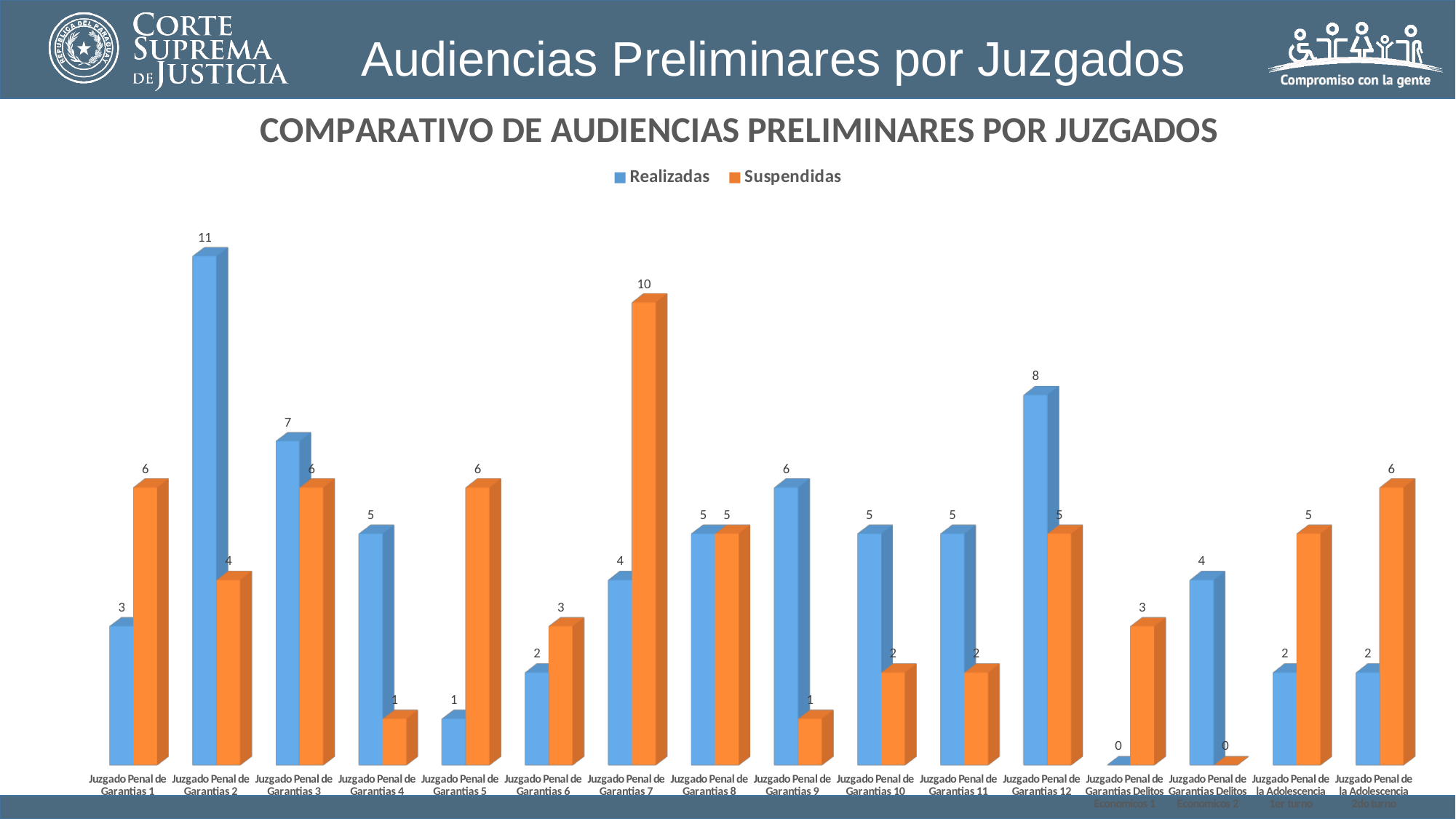
How many series does the legend list? 2 What is the difference between Realizadas and Suspendidas for Juzgado Penal de Garantias 2? 7 For Juzgado Penal de Garantias 9, which is larger, Realizadas or Suspendidas? Realizadas What is the Realizadas value for Juzgado Penal de Garantias 2? 11 What is the Realizadas value for Juzgado Penal de Garantias 12? 8 What is the difference between Suspendidas and Realizadas for Juzgado Penal de Garantias 7? 6 How many juzgados (categories) are shown on the x axis? 16 Which juzgado has the lowest Realizadas value? Juzgado Penal de Garantias Delitos Economicos 1 Which juzgado has the highest Realizadas value? Juzgado Penal de Garantias 2 What is the Suspendidas value for Juzgado Penal de Garantias 7? 10 Which juzgado has the highest Suspendidas value? Juzgado Penal de Garantias 7 What type of chart is shown on the slide? Bar chart